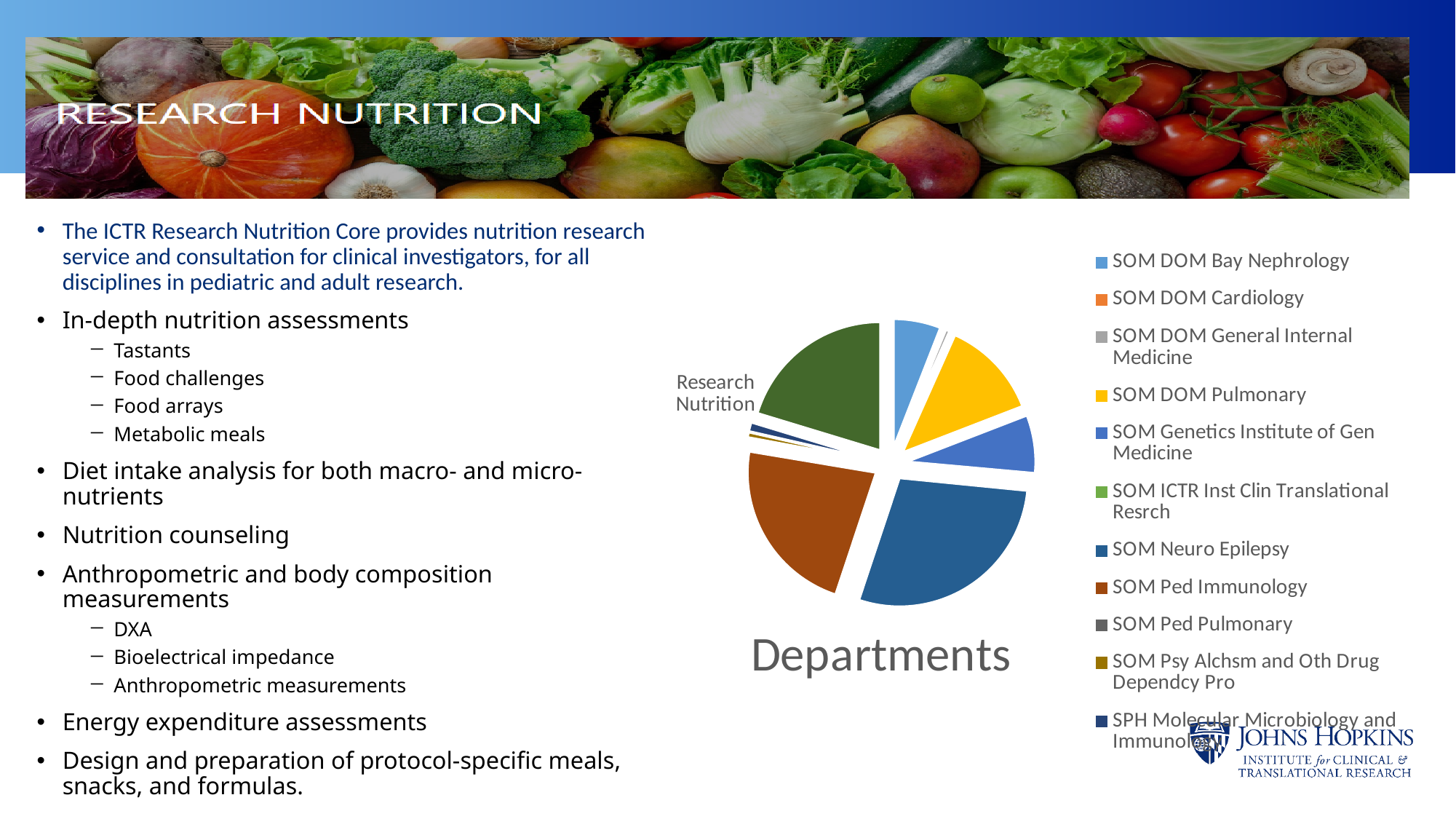
In the Departments pie chart, which slice is larger: SOM DOM Pulmonary or SOM Genetics Institute of Gen Medicine? SOM DOM Pulmonary Which colour represents SOM Ped Immunology in the Departments pie chart? brown In the Departments pie chart, which slice is larger: SOM Ped Immunology or SOM DOM Pulmonary? SOM Ped Immunology How many departments are listed in the legend of the Departments pie chart? 11 Which department has the largest slice in the Departments pie chart? SOM Neuro Epilepsy In the Departments pie chart, which slice is larger: SOM Neuro Epilepsy or SOM Ped Immunology? SOM Neuro Epilepsy What is the title of the pie chart on the slide? Departments What kind of chart is shown under the title "Departments"? pie chart